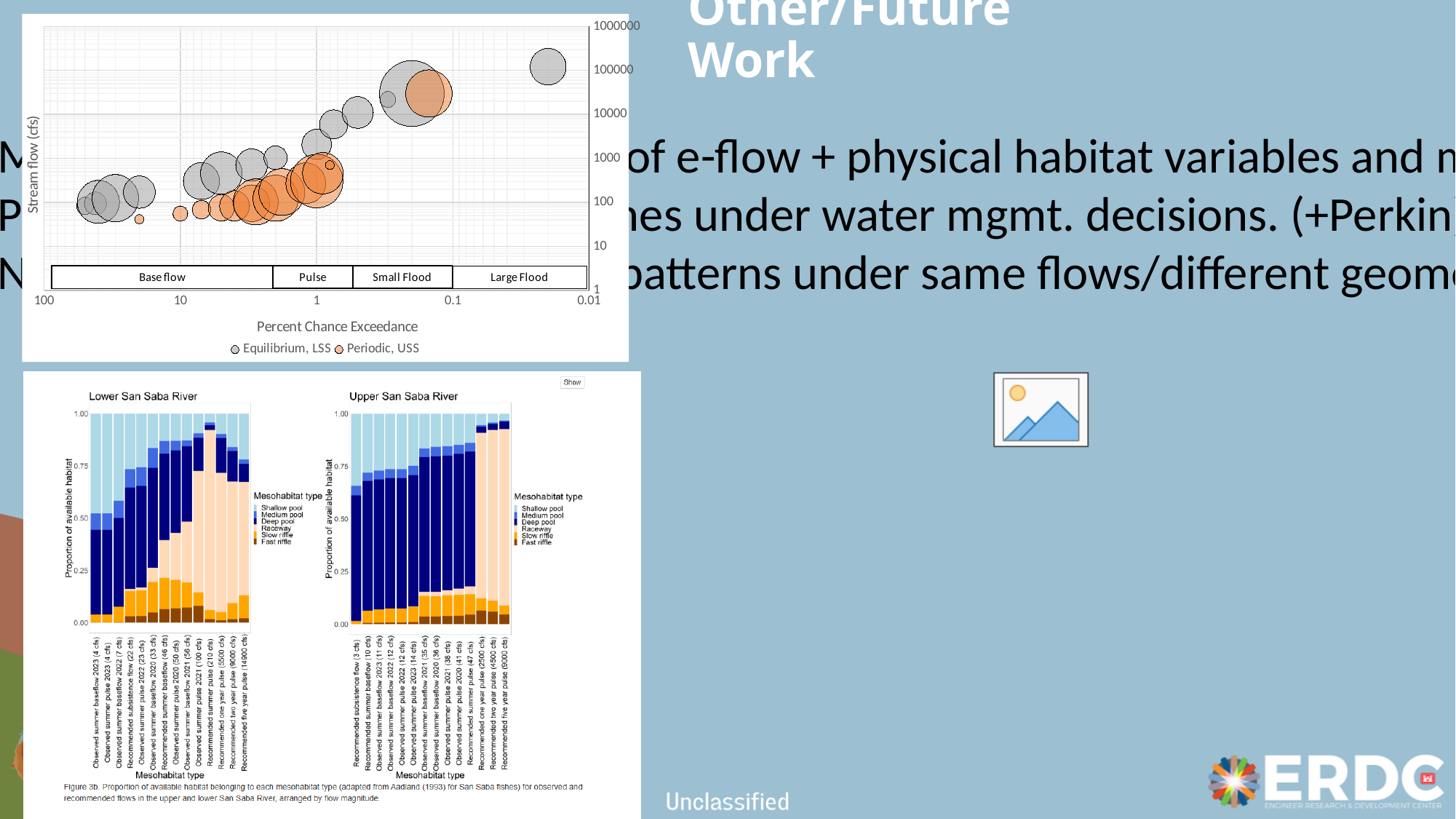
What are the titles of the two panels in the bottom Figure 3b chart? Lower San Saba River and Upper San Saba River How many mesohabitat types does the legend of the bottom Figure 3b chart list? 6 In the top Stream flow chart, do the bubbles rise or fall in stream flow moving from left to right along the x axis? rise What kind of chart is the bottom Figure 3b showing proportion of available habitat? stacked bar chart What kind of chart is the top chart of Stream flow versus Percent Chance Exceedance? bubble chart How many flow categories (Base flow, Pulse, etc.) are labelled along the bottom of the top Stream flow chart? 4 How many bars are in the Lower San Saba River panel of the bottom Figure 3b chart? 14 How many series does the legend of the top Stream flow chart list? 2 How many bars are in the Upper San Saba River panel of the bottom Figure 3b chart? 14 What are the two legend entries of the top Stream flow chart? Equilibrium, LSS and Periodic, USS